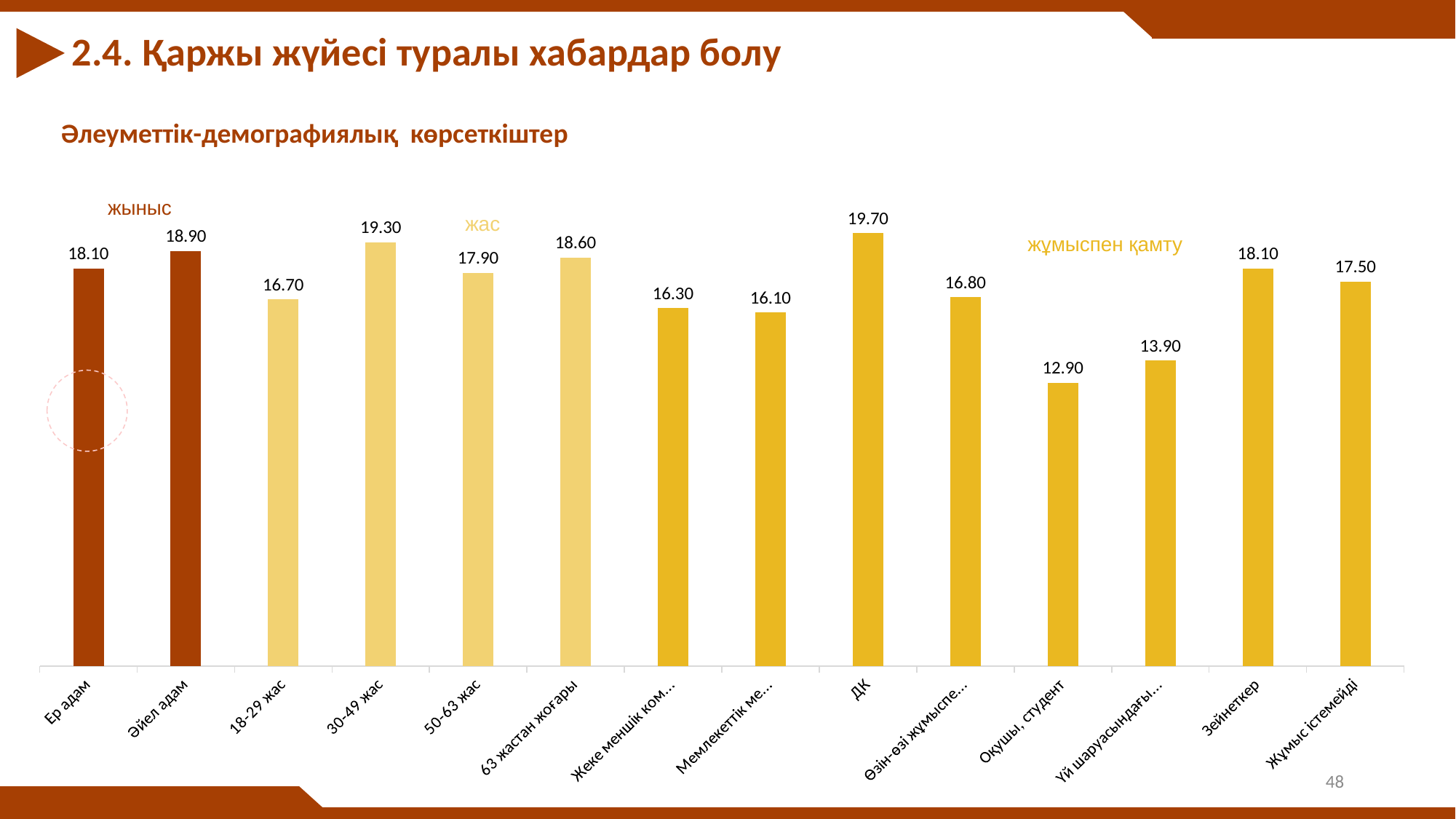
Which category has the highest value? ДК What is the value for Ер адам? 18.10 Which category has the lowest value? Оқушы, студент Which is larger, the value for 50-63 жас or the value for 63 жастан жоғары? 63 жастан жоғары What is the difference between the values for 30-49 жас and 18-29 жас? 2.60 What is the value for Зейнеткер? 18.10 What kind of chart is shown on the slide? Bar chart What is the value for Әйел адам? 18.90 How many bars are shown in the chart? 14 What is the value for 30-49 жас? 19.30 What is the value for Жұмыс істемейді? 17.50 What is the difference between the values for Әйел адам and Ер адам? 0.80